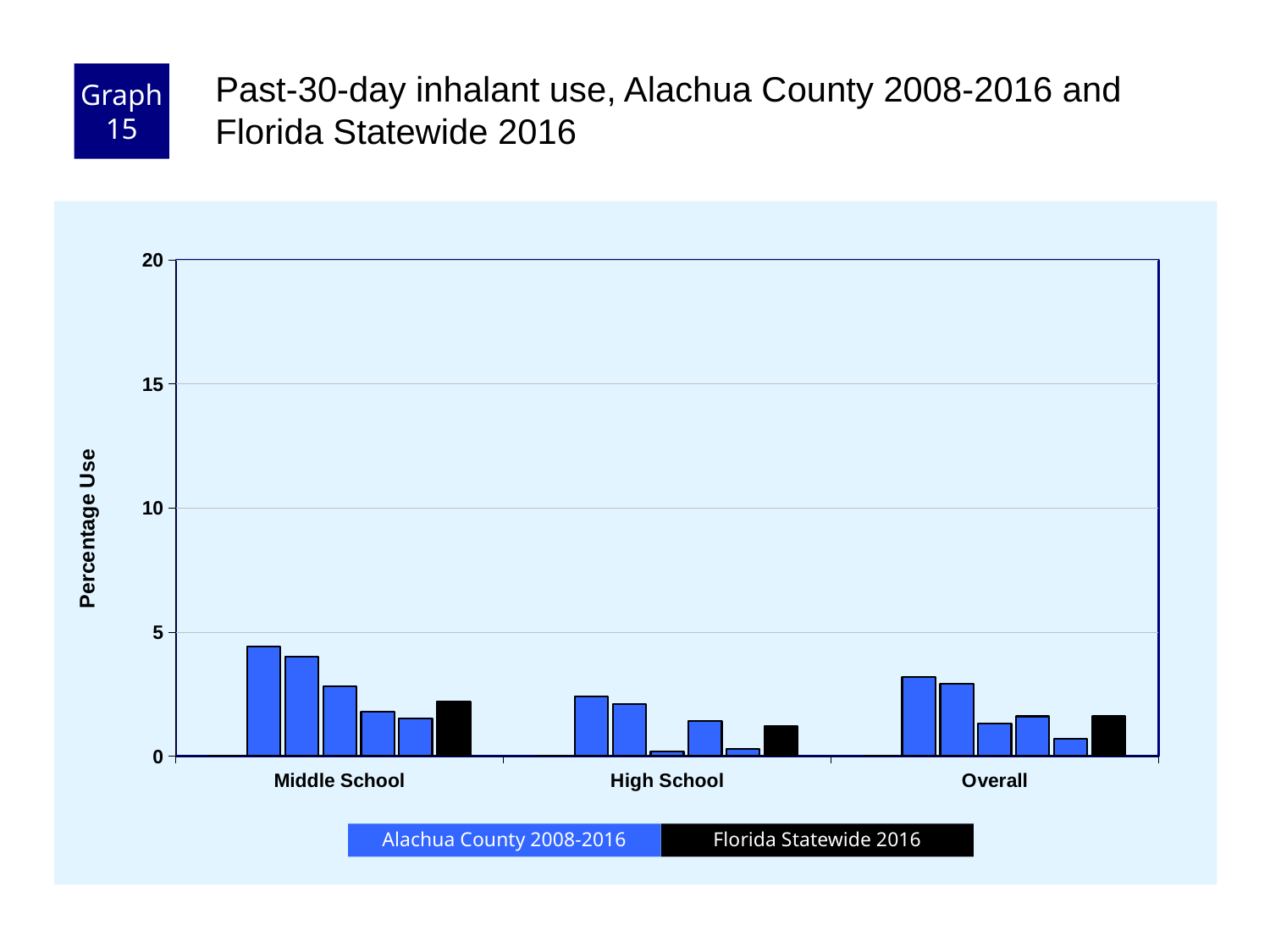
Is the tallest Alachua County bar for Middle School greater or less than 5? less Do the Alachua County bars for Middle School rise or fall from left to right? fall Is the Florida Statewide 2016 bar for High School greater or less than 5? less How many categories are shown on the x axis? 3 What is the label on the vertical axis? Percentage Use Is the Florida Statewide 2016 bar for Overall greater or less than 10? less How many series does the legend list? 2 What are the two series named in the legend? Alachua County 2008-2016 and Florida Statewide 2016 Which category has the highest Florida Statewide 2016 bar? Middle School Which category has the lowest Florida Statewide 2016 bar? High School Which is larger: the Florida Statewide 2016 bar for Middle School or for High School? Middle School What kind of chart is shown on the slide? bar chart